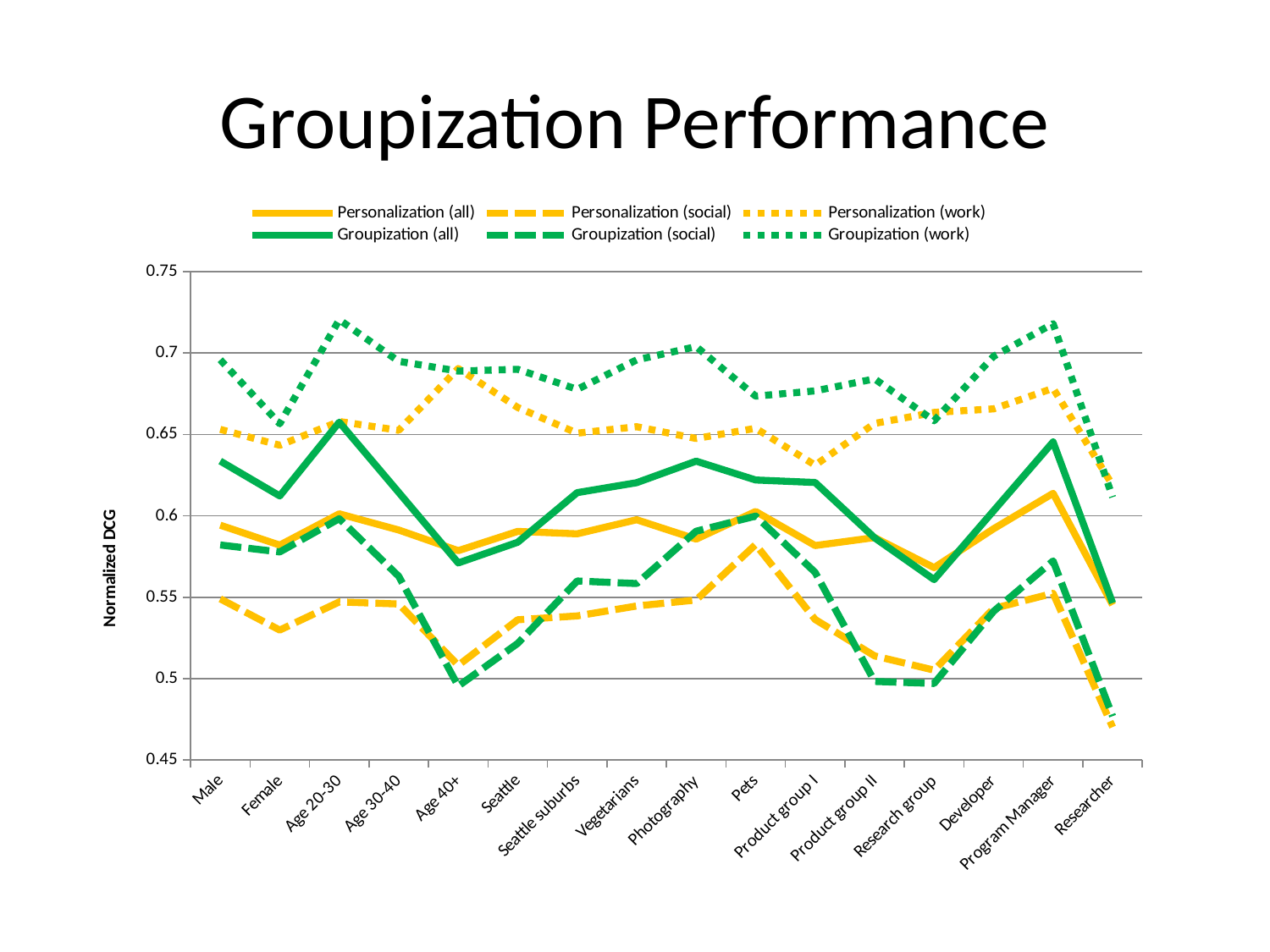
For which category is Personalization (all) highest? Program Manager Which colour are the Groupization series drawn in? green What is the label of the y axis? Normalized DCG How many categories are shown along the x axis? 16 What kind of chart is shown on the slide? line chart How many series does the legend list? 6 Is the value for Groupization (work) at Age 20-30 greater or less than 0.7? greater Is the value for Personalization (work) at Age 40+ greater or less than 0.65? greater At Male, which is larger: Groupization (all) or Personalization (all)? Groupization (all) Is the value for Personalization (social) at Researcher greater or less than 0.5? less For which category is Personalization (social) lowest? Researcher